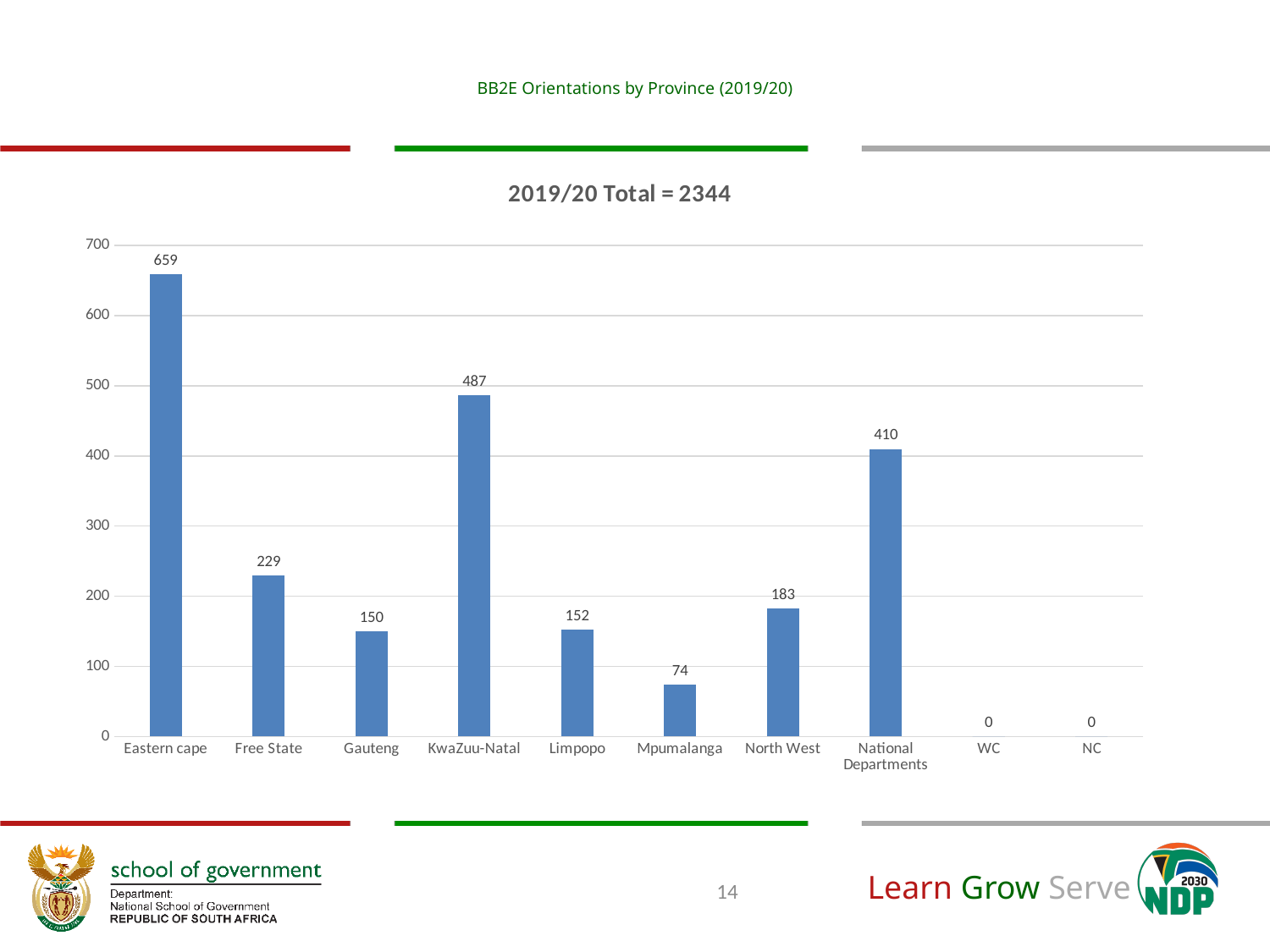
What is the difference between the values for KwaZuu-Natal and Free State? 258 What kind of chart is shown? bar chart Is the value for Gauteng greater or less than 200? less Which two categories have a value of 0? WC and NC What is the value for Eastern cape? 659 What is the chart title? 2019/20 Total = 2344 Which category has the highest value? Eastern cape Which is larger, the value for North West or the value for Limpopo? North West Which category has the highest non-zero value after Eastern cape? KwaZuu-Natal What is the value for Mpumalanga? 74 How many categories are shown on the x axis? 10 What is the value for National Departments? 410